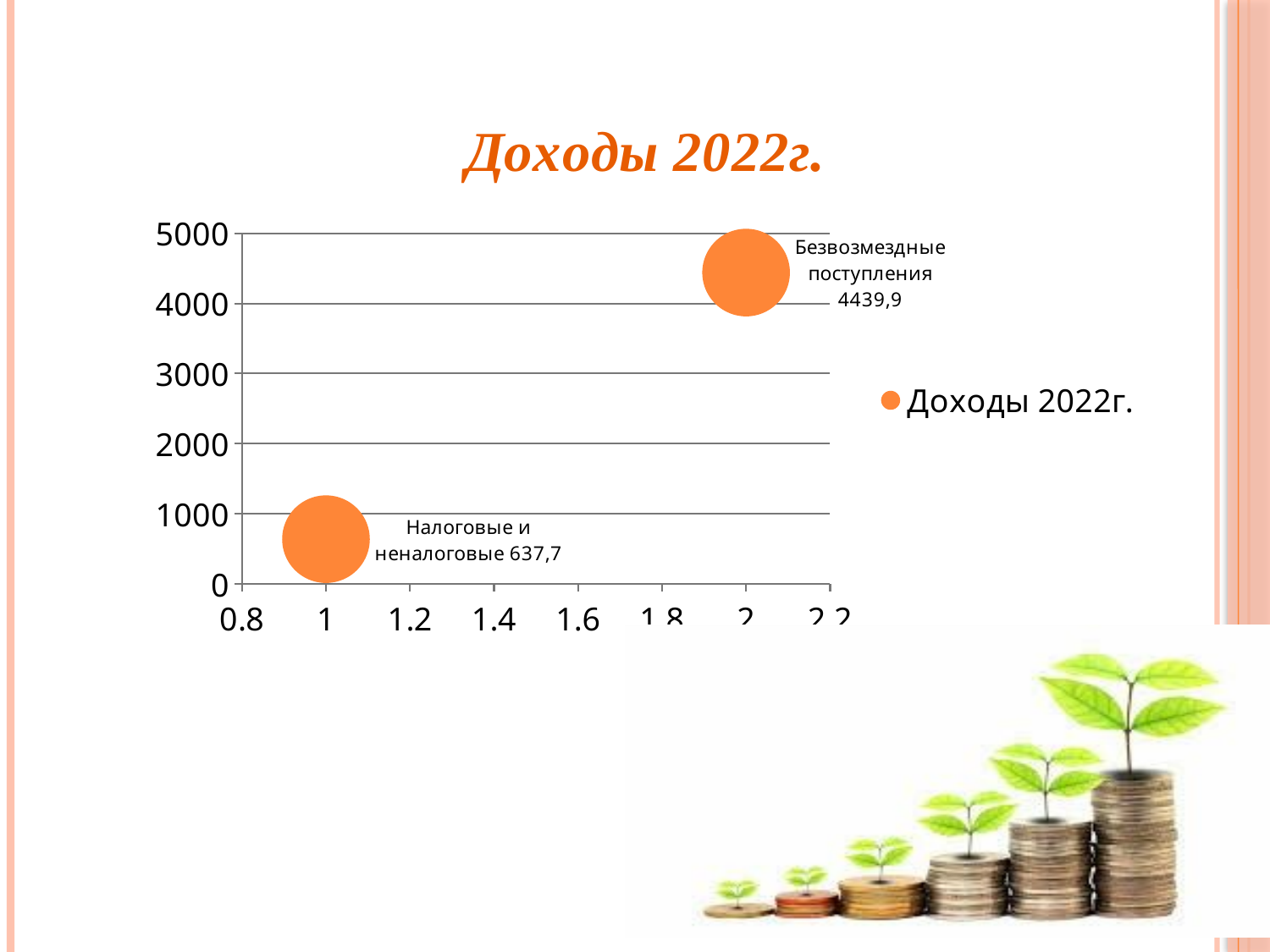
Which category has the highest value? Безвозмездные поступления Which is larger: Безвозмездные поступления or Налоговые и неналоговые? Безвозмездные поступления Which category has the lowest value? Налоговые и неналоговые What is the value for Налоговые и неналоговые? 637,7 What kind of chart is shown on the slide? bubble chart What is the title of the chart? Доходы 2022г. What is the difference between the values for Безвозмездные поступления and Налоговые и неналоговые? 3802,2 Is the value for Безвозмездные поступления greater or less than 4000? greater How many series does the legend list? 1 Is the value for Налоговые и неналоговые greater or less than 1000? less What is the value for Безвозмездные поступления? 4439,9 How many data points are plotted on the chart? 2